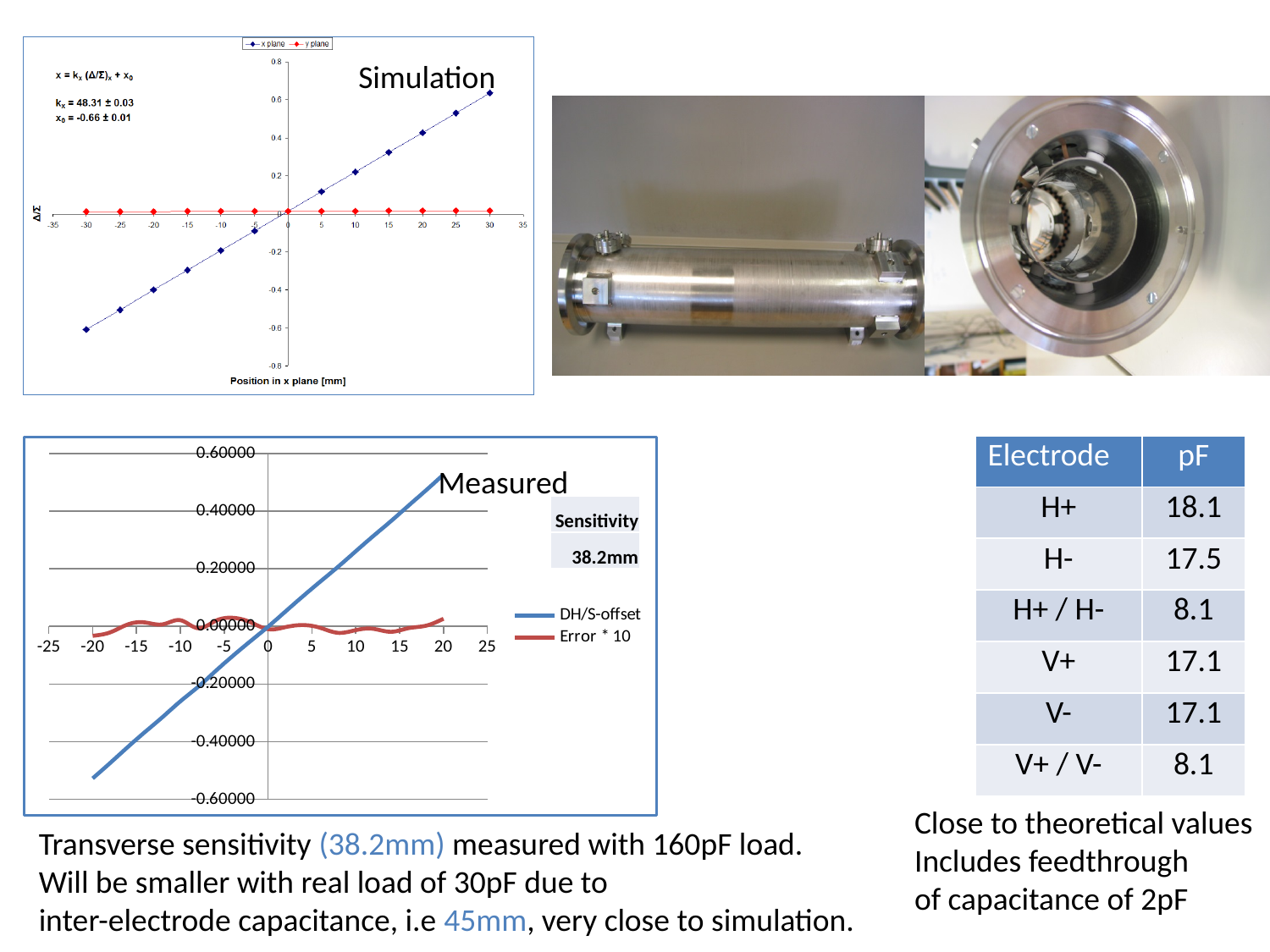
In the Simulation chart, is the x plane value at position 30 greater or less than 0.4? greater What are the two series named in the legend of the Simulation chart? x plane and y plane In the Measured chart, is the DH/S-offset value at x = 20 greater or less than 0.40000? greater In the Simulation chart, is the x plane value at position -30 greater or less than -0.4? less In the Simulation chart, does the x plane series rise or fall as position increases along the x axis? rise What kind of chart is the Measured chart at the bottom left of the slide? line chart What kind of chart is the Simulation chart at the top left of the slide? line chart How many series does the legend of the Measured chart list? 2 In the Measured chart, which series has the larger value at x = 20, DH/S-offset or Error * 10? DH/S-offset How many series does the legend of the Simulation chart list? 2 What is the x-axis title of the Simulation chart? Position in x plane [mm] In the Measured chart, does the DH/S-offset series rise or fall as the x value increases? rise